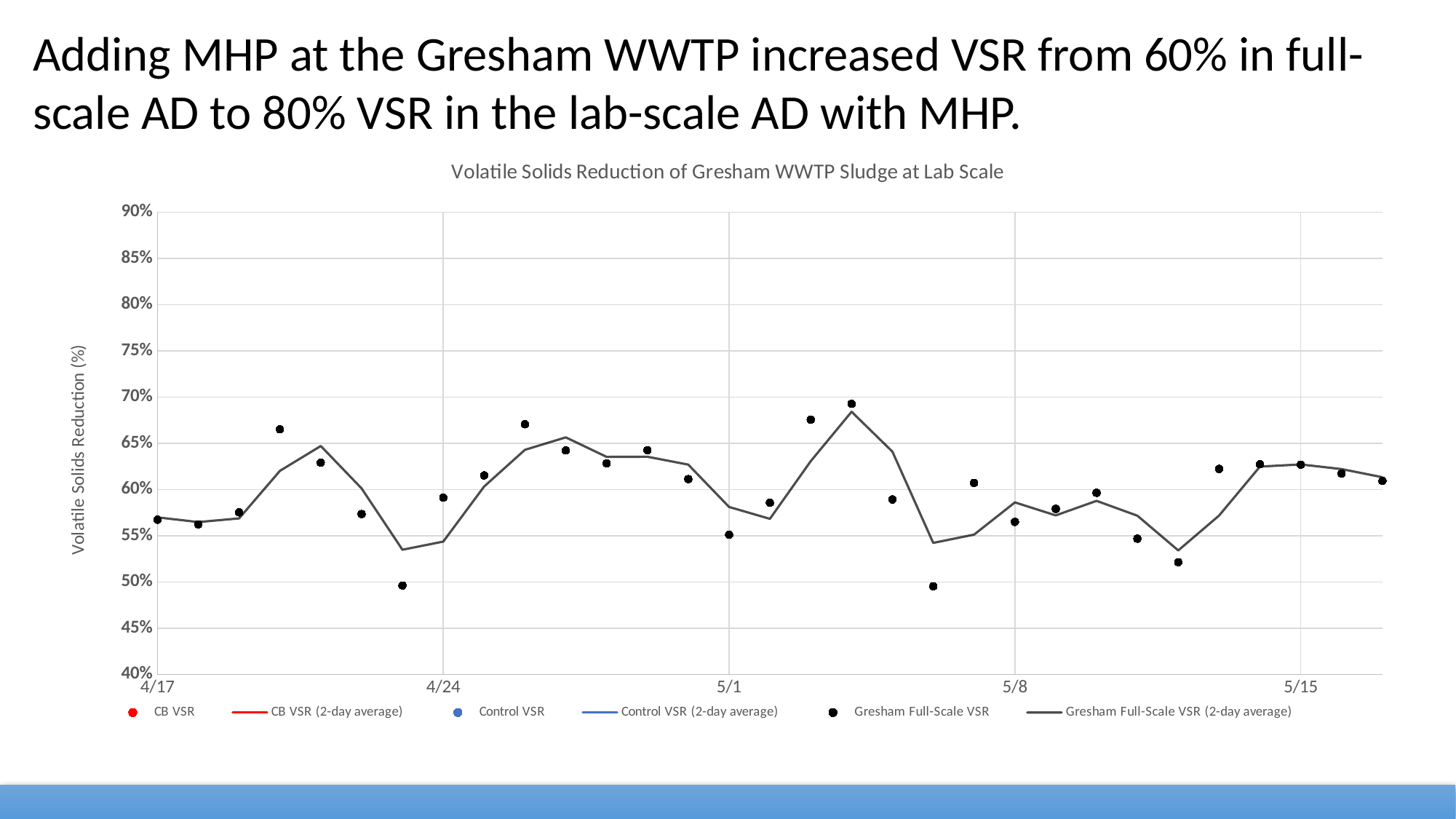
Is the Gresham Full-Scale VSR value on 5/15 greater or less than 60%? greater What is the title of the chart? Volatile Solids Reduction of Gresham WWTP Sludge at Lab Scale Is the Gresham Full-Scale VSR value on 5/1 greater or less than 60%? less Is the highest Gresham Full-Scale VSR point greater or less than 65%? greater Which is larger, the Gresham Full-Scale VSR value on 4/24 or on 5/1? 4/24 How many series does the chart legend list? 6 What is the label of the vertical axis? Volatile Solids Reduction (%) How many Gresham Full-Scale VSR data points are plotted on the chart? 31 What kind of chart is shown on the slide? Scatter chart with points and lines Which is larger, the Gresham Full-Scale VSR value on 4/17 or on 5/15? 5/15